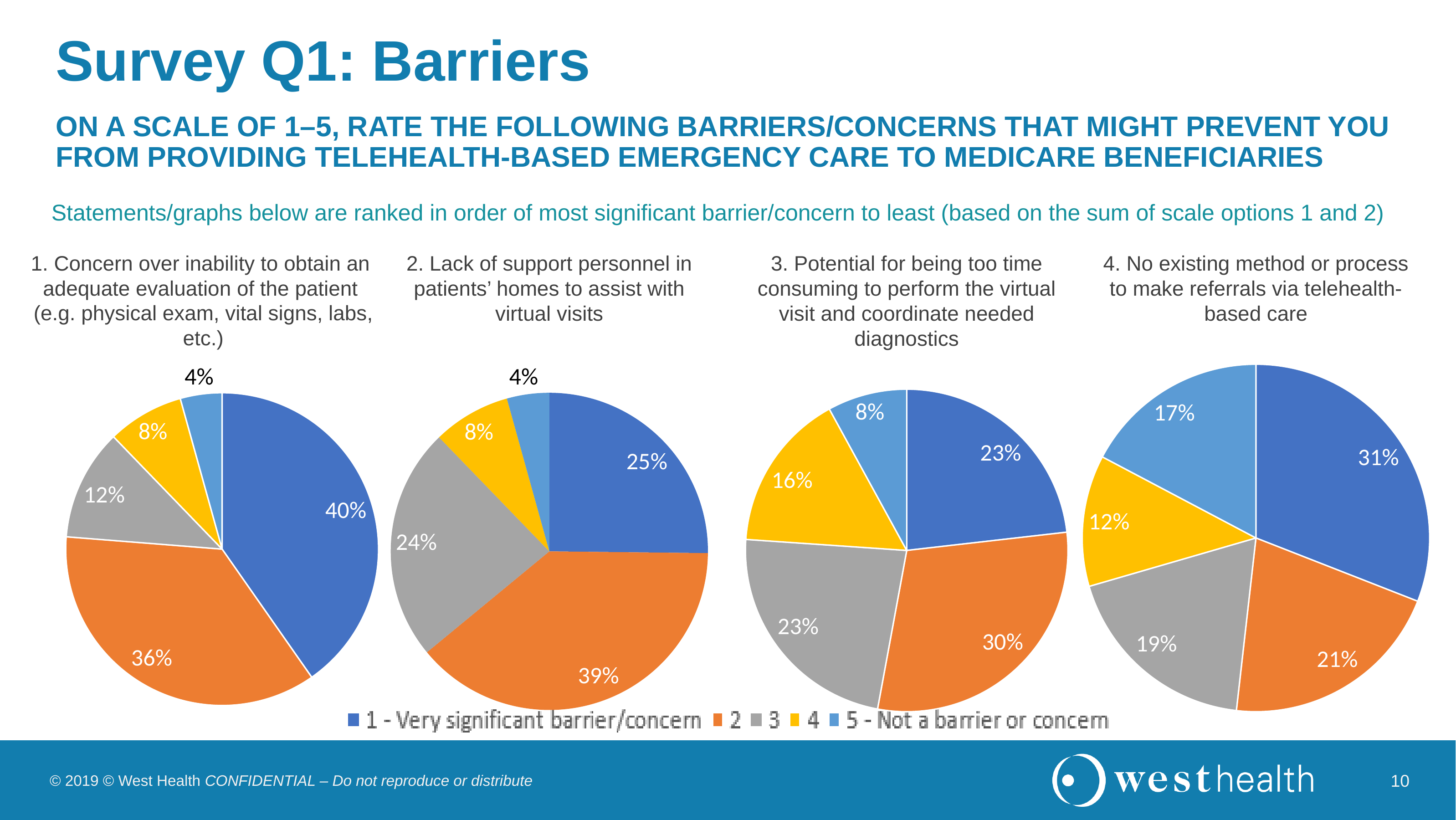
How many slices does the pie chart for barrier 3 (Potential for being too time consuming) have? 5 In the pie chart for barrier 2 (Lack of support personnel in patients' homes), what is the difference between the share rated 2 and the share rated 1? 14% In the pie chart for barrier 1 (Concern over inability to obtain an adequate evaluation of the patient), what share is rated 1 - Very significant barrier/concern? 40% What type of chart is used for each of the four barriers on the slide? Pie chart In the pie chart for barrier 2 (Lack of support personnel in patients' homes), what share is rated 2? 39% How many entries does the shared legend list? 5 In the pie chart for barrier 3 (Potential for being too time consuming), what share is rated 5 - Not a barrier or concern? 8% In the pie chart for barrier 3 (Potential for being too time consuming), which is larger: the share rated 2 or the share rated 4? 2 In the pie chart for barrier 4 (No existing method or process to make referrals), what share is rated 3? 19% In the pie chart for barrier 4 (No existing method or process to make referrals), which rating has the largest slice? 1 - Very significant barrier/concern In the legend, which colour represents the rating 5 - Not a barrier or concern? Light blue In the pie chart for barrier 1 (Concern over inability to obtain an adequate evaluation of the patient), which rating has the smallest slice? 5 - Not a barrier or concern